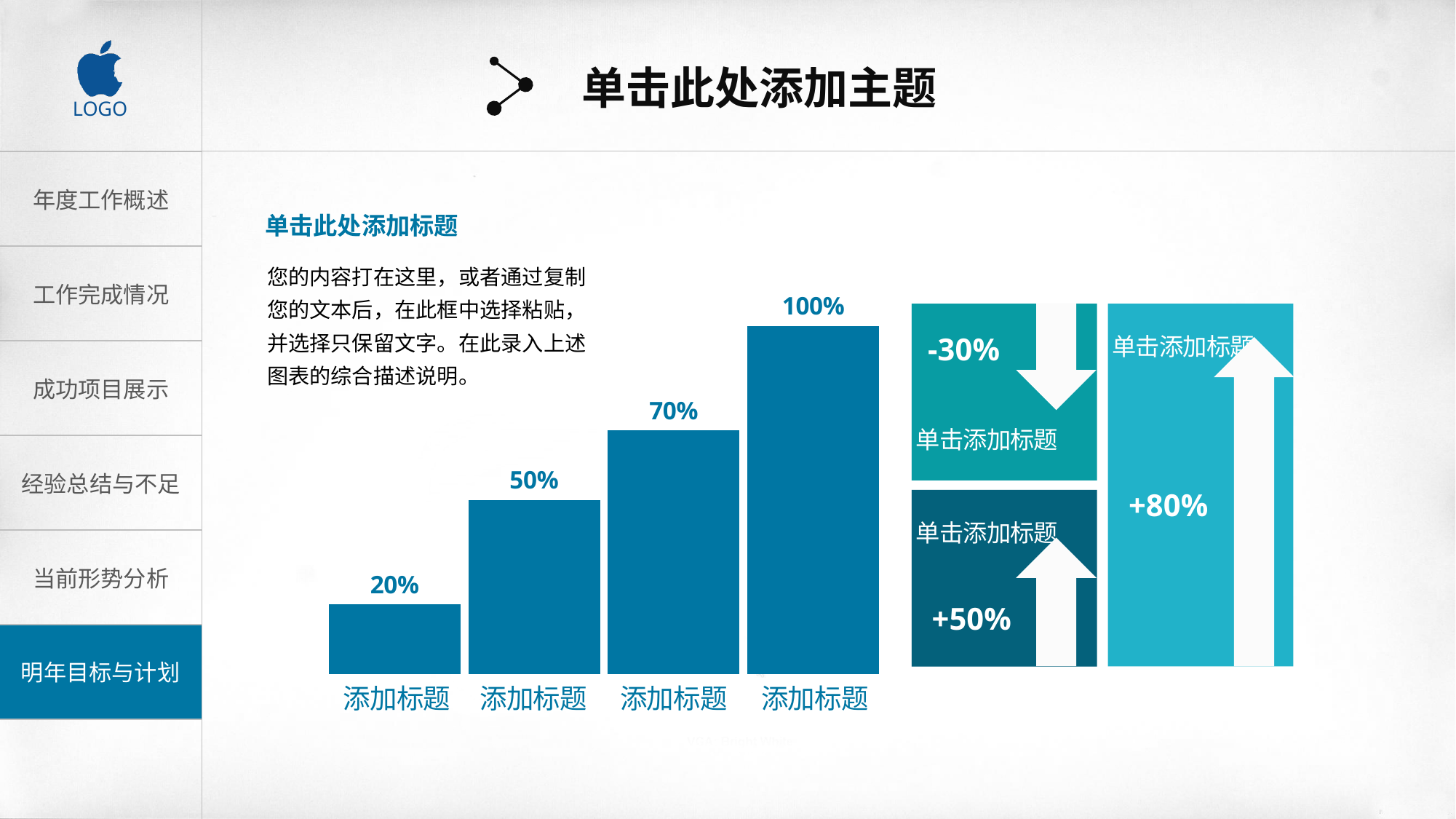
What is the difference between the rightmost bar and the leftmost bar in the bar chart? 80% Which bar in the bar chart has the highest value? the rightmost bar (100%) What kind of chart is shown on the slide? bar chart How many bars does the bar chart have? 4 Do the bar values rise or fall from left to right in the bar chart? rise What is the value of the second bar from the left in the bar chart? 50% What label is printed under each bar in the bar chart? 添加标题 What is the value of the rightmost bar in the bar chart? 100% What is the value of the third bar from the left in the bar chart? 70% Which bar in the bar chart has the lowest value? the leftmost bar (20%) What is the value of the leftmost bar in the bar chart? 20% What is the difference between the third bar and the second bar in the bar chart? 20%